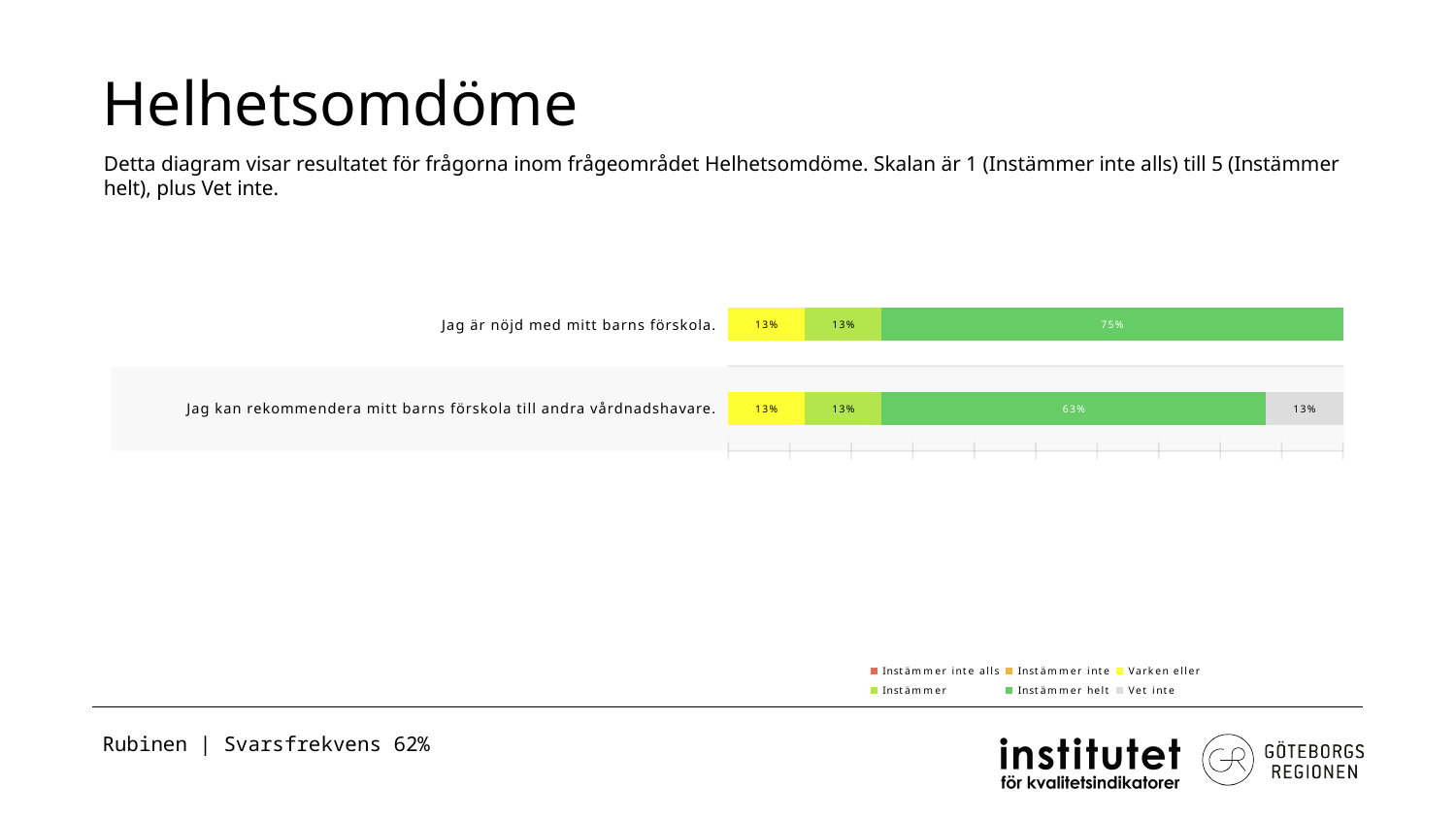
Is the "Instämmer" value for "Jag är nöjd med mitt barns förskola." larger or smaller than its "Instämmer helt" value? Smaller What is the total of the segments in the bar for "Jag är nöjd med mitt barns förskola."? 101% What is the value for "Instämmer helt" for "Jag är nöjd med mitt barns förskola."? 75% What is the value for "Instämmer helt" for "Jag kan rekommendera mitt barns förskola till andra vårdnadshavare."? 63% What kind of chart is shown on the slide? Stacked bar chart How many categories (statements) are plotted in the chart? 2 What is the value for "Vet inte" for "Jag kan rekommendera mitt barns förskola till andra vårdnadshavare."? 13% How many series does the legend list? 6 Which legend entry is shown in grey? Vet inte Which statement has the higher "Instämmer helt" value? Jag är nöjd med mitt barns förskola. What is the value for "Varken eller" for "Jag är nöjd med mitt barns förskola."? 13% What is the difference between the "Instämmer helt" values for the two statements? 12%